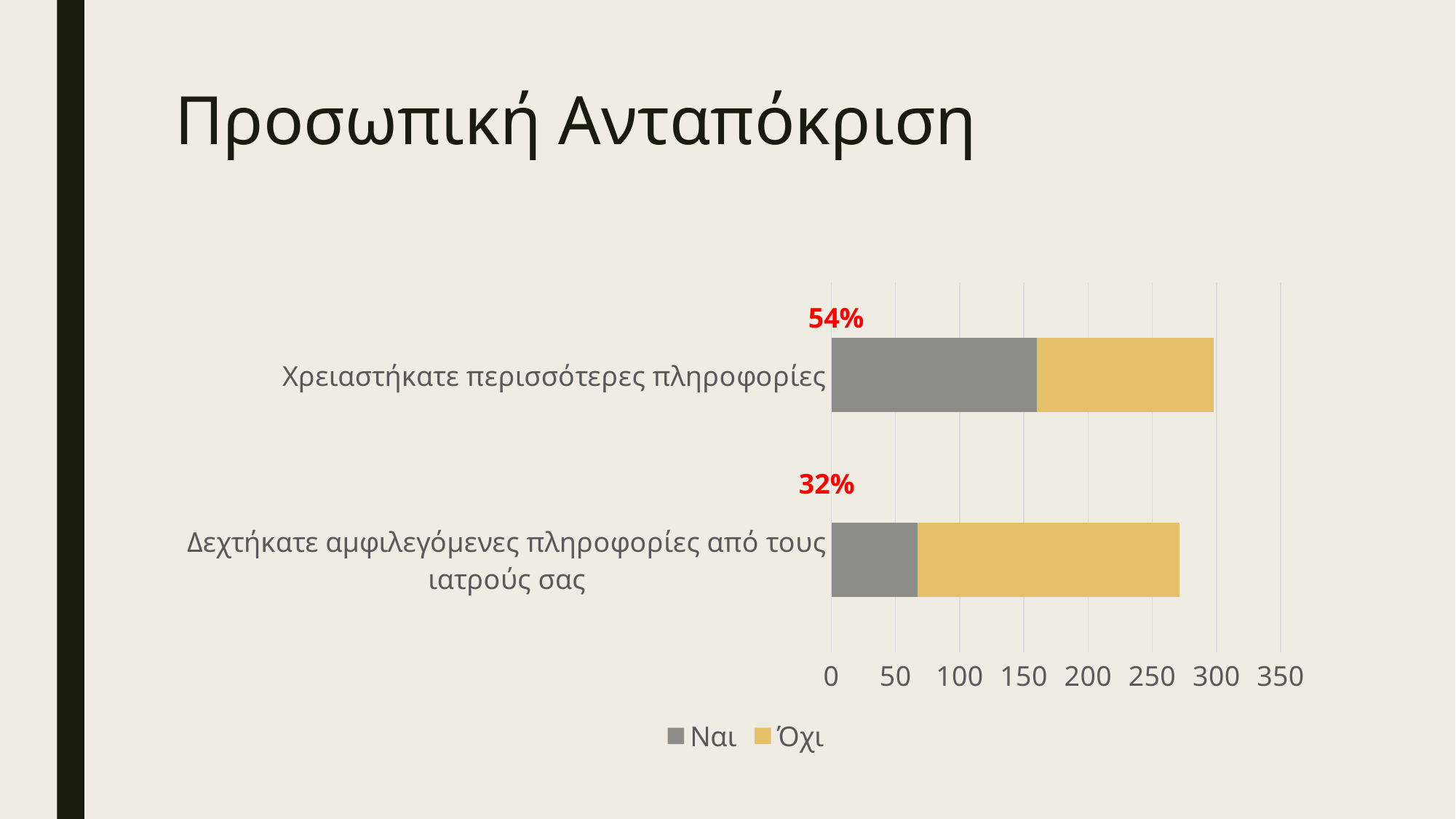
Which category has the larger Ναι segment? Χρειαστήκατε περισσότερες πληροφορίες Which category has the larger Όχι segment? Δεχτήκατε αμφιλεγόμενες πληροφορίες από τους ιατρούς σας What kind of chart is shown on the slide? bar chart How many categories does the chart show? 2 What percentage is printed in red above the bar for "Δεχτήκατε αμφιλεγόμενες πληροφορίες από τους ιατρούς σας"? 32% How many series does the legend list? 2 Is the Ναι value for "Χρειαστήκατε περισσότερες πληροφορίες" greater or less than 100? greater Is the Ναι value for "Δεχτήκατε αμφιλεγόμενες πληροφορίες από τους ιατρούς σας" greater or less than 100? less What is the title of the slide containing the chart? Προσωπική Ανταπόκριση What percentage is printed in red above the bar for "Χρειαστήκατε περισσότερες πληροφορίες"? 54% What are the two series named in the legend? Ναι and Όχι Is the total length of the stacked bar for "Δεχτήκατε αμφιλεγόμενες πληροφορίες από τους ιατρούς σας" greater or less than 250? greater